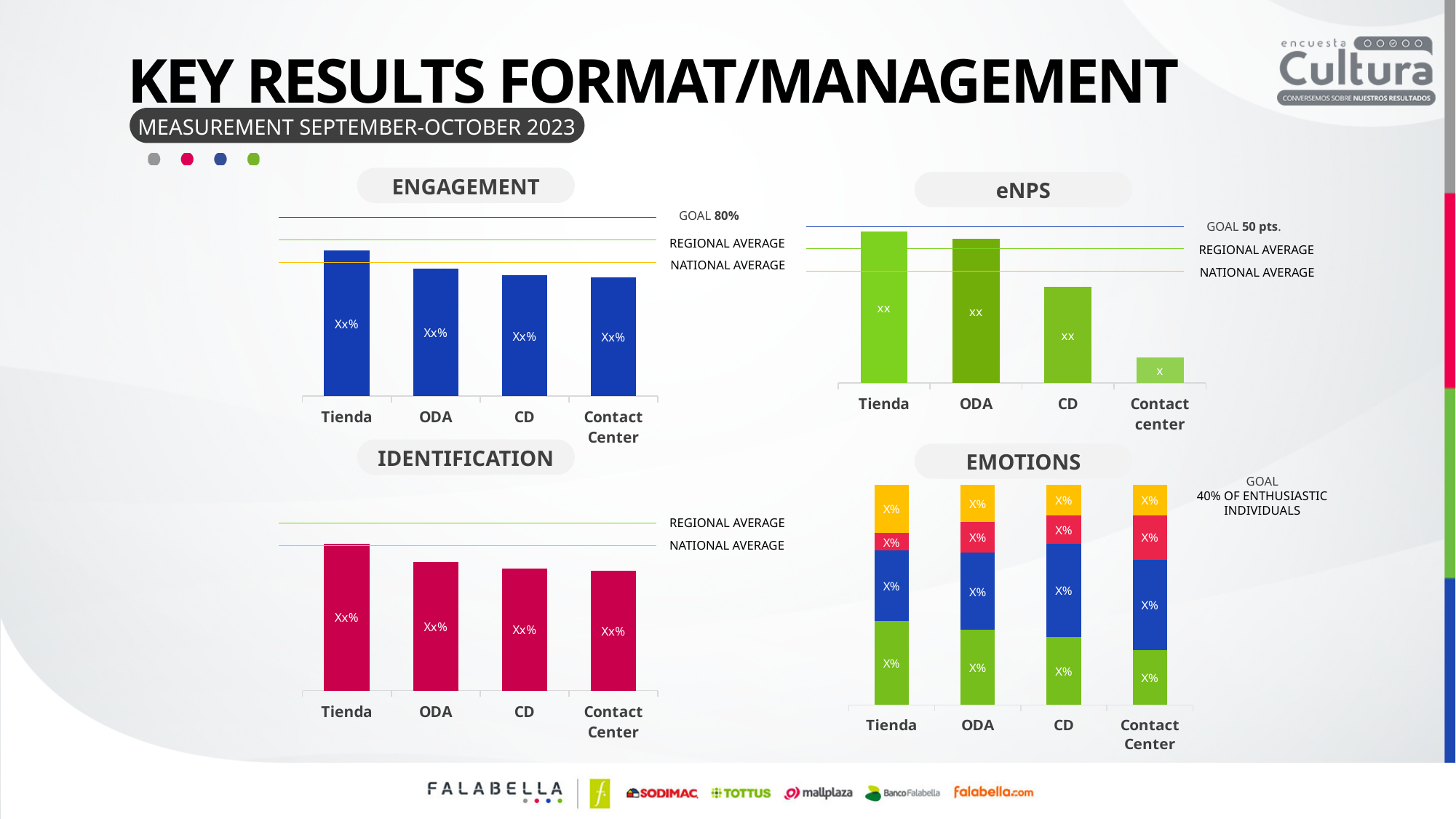
On the ENGAGEMENT chart, which category has the highest bar? Tienda How many categories are shown on the EMOTIONS chart? 4 What goal value is shown on the ENGAGEMENT chart? 80% How many categories are shown on the ENGAGEMENT chart? 4 What goal value is shown on the eNPS chart? 50 pts. On the eNPS chart, which category has the lowest bar? Contact center On the eNPS chart, which category has the highest bar? Tienda On the eNPS chart, do the bars rise or fall from Tienda to Contact center? fall On the IDENTIFICATION chart, which is larger, the bar for ODA or the bar for CD? ODA On the IDENTIFICATION chart, which category has the highest bar? Tienda What kind of chart is the ENGAGEMENT chart? bar chart